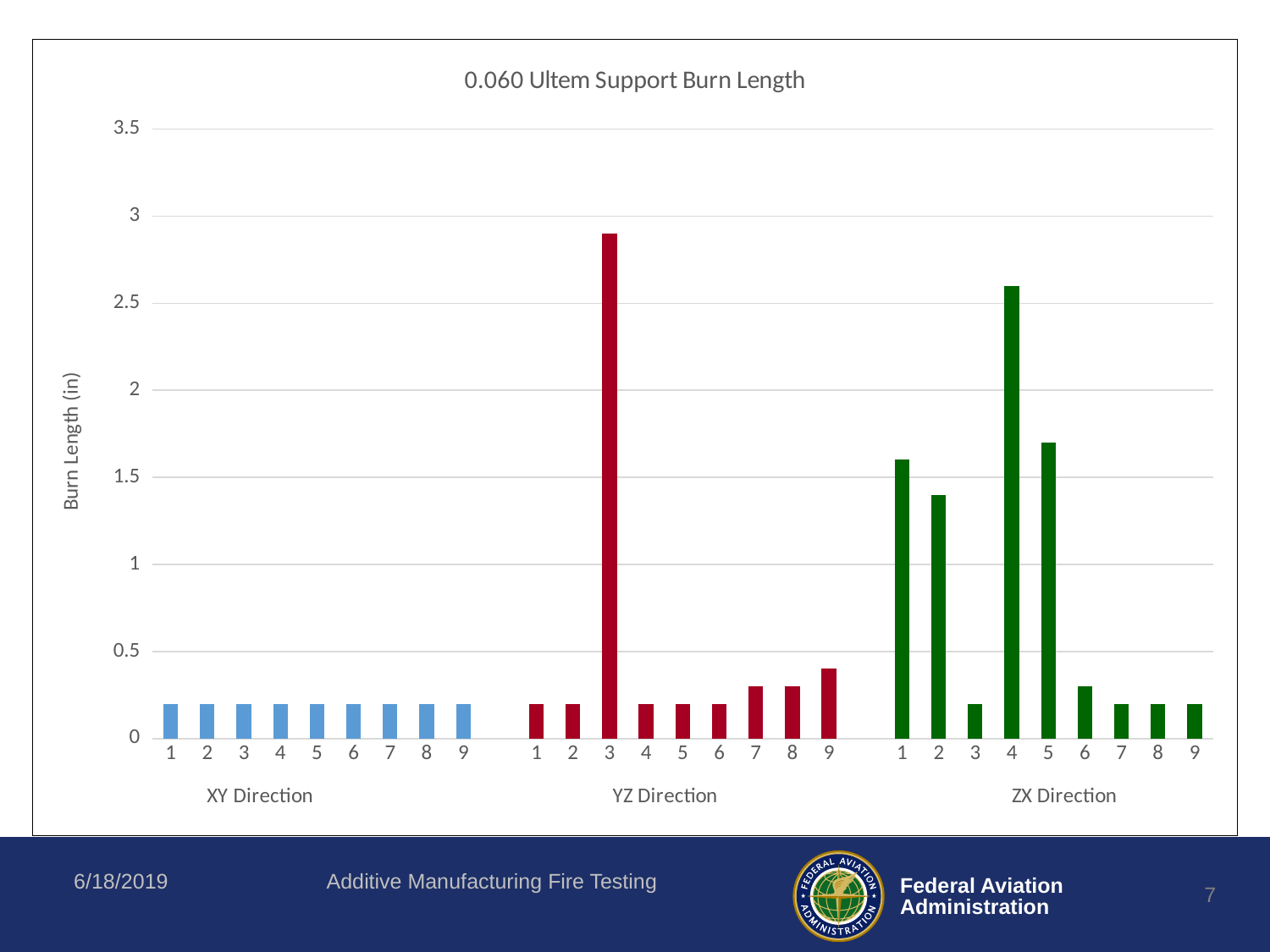
Which sample in the ZX Direction group has the highest burn length? 4 What is the label of the vertical axis? Burn Length (in) Which is larger: the burn length for sample 3 in the YZ Direction or sample 4 in the ZX Direction? Sample 3 in the YZ Direction Is the burn length for sample 1 in the ZX Direction greater or less than 1.5? greater Is the burn length for sample 3 in the YZ Direction greater or less than 2.5? greater How many direction groups are shown along the x axis? 3 What is the title of the chart? 0.060 Ultem Support Burn Length Which direction group contains the tallest bar on the chart? YZ Direction What kind of chart is shown on the slide? Bar chart Is the burn length for sample 4 in the ZX Direction greater or less than 3? less Which sample in the YZ Direction group has the highest burn length? 3 How many samples are plotted in the XY Direction group? 9